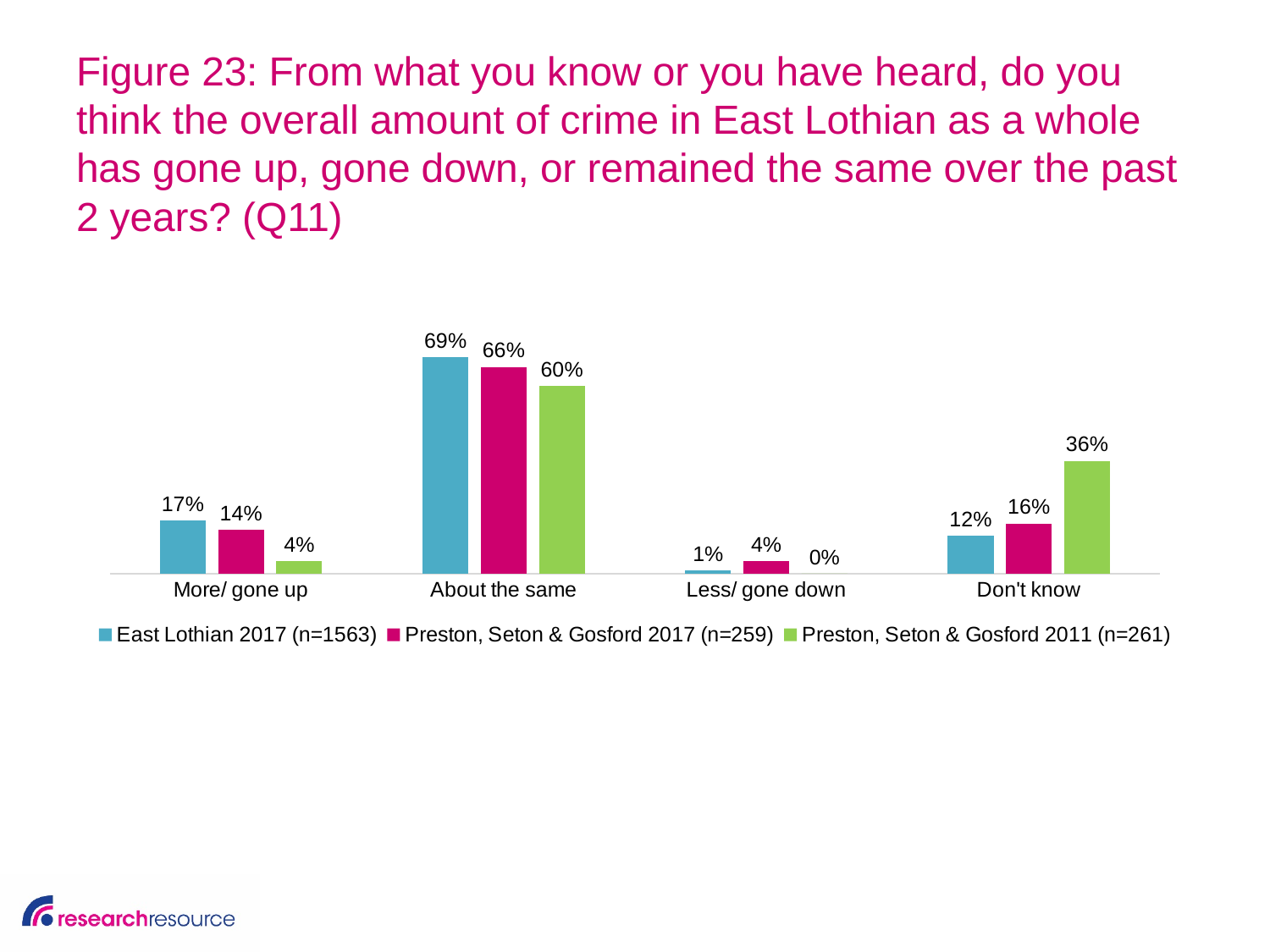
What percentage of East Lothian 2017 respondents said crime had gone up (More/ gone up)? 17% What is the value for Preston, Seton & Gosford 2011 in the 'Less/ gone down' category? 0% How many response categories are shown on the x axis? 4 What is the value for Preston, Seton & Gosford 2011 in the 'Don't know' category? 36% What type of chart is shown on the slide? Bar chart What is the difference between the Preston, Seton & Gosford 2011 and Preston, Seton & Gosford 2017 values for 'Don't know'? 20% How many series does the legend list? 3 What is the value for Preston, Seton & Gosford 2017 in the 'About the same' category? 66% Which category has the lowest value for Preston, Seton & Gosford 2017? Less/ gone down Which category has the highest value for East Lothian 2017? About the same What is the sample size (n) for the Preston, Seton & Gosford 2017 series shown in the legend? 259 Which is larger for 'More/ gone up': East Lothian 2017 or Preston, Seton & Gosford 2011? East Lothian 2017